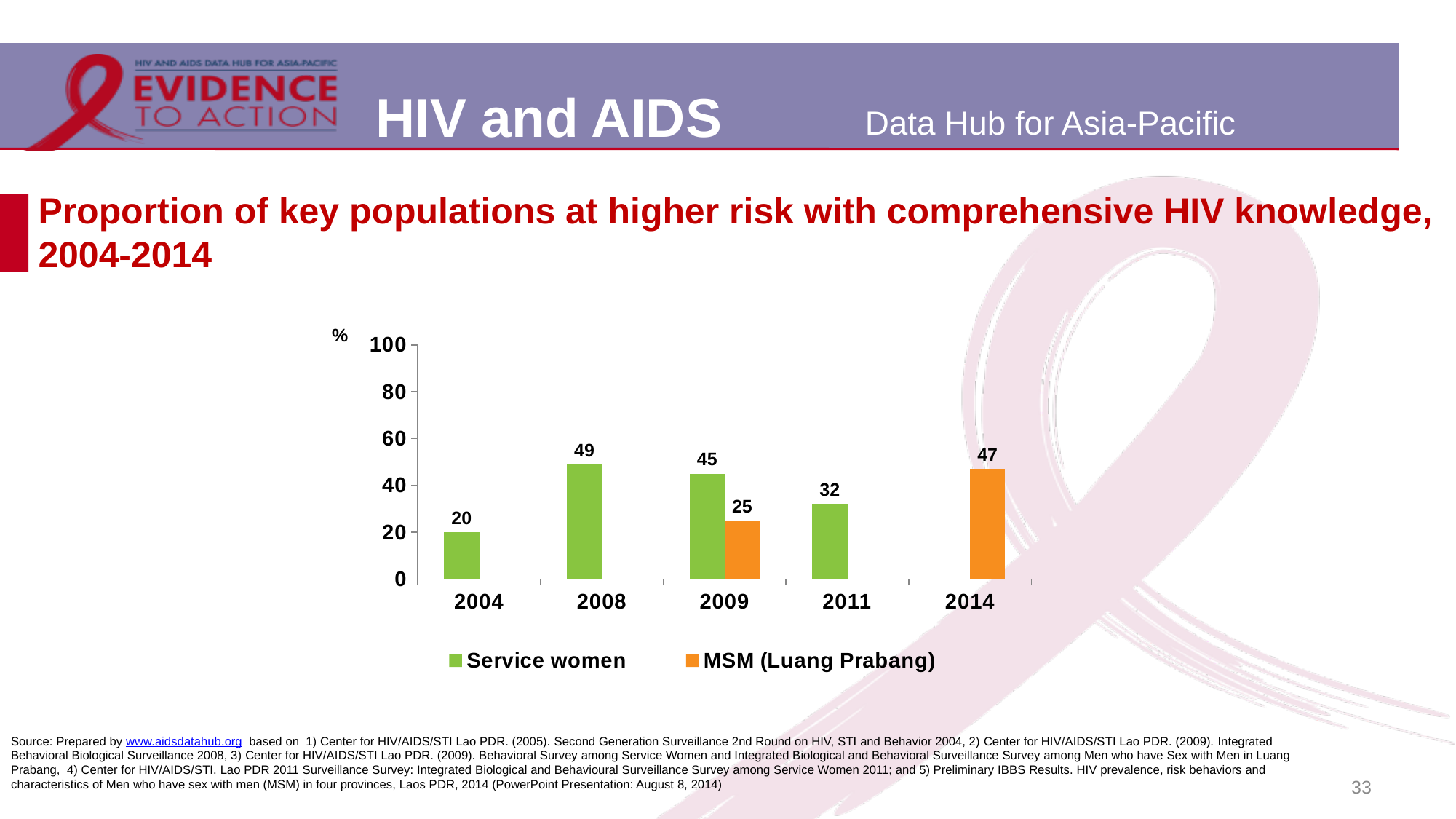
In which year is the Service women value lowest? 2004 In which year is the Service women value highest? 2008 What kind of chart is shown on the slide? Bar chart What is the value for Service women in 2004? 20 How many years are shown on the x axis? 5 What is the value for Service women in 2008? 49 What is the value for MSM (Luang Prabang) in 2014? 47 How many series does the legend list? 2 What colour are the bars for MSM (Luang Prabang)? Orange What is the value for MSM (Luang Prabang) in 2009? 25 What is the difference between the Service women and MSM (Luang Prabang) values in 2009? 20 Which is larger in 2009, the Service women value or the MSM (Luang Prabang) value? Service women